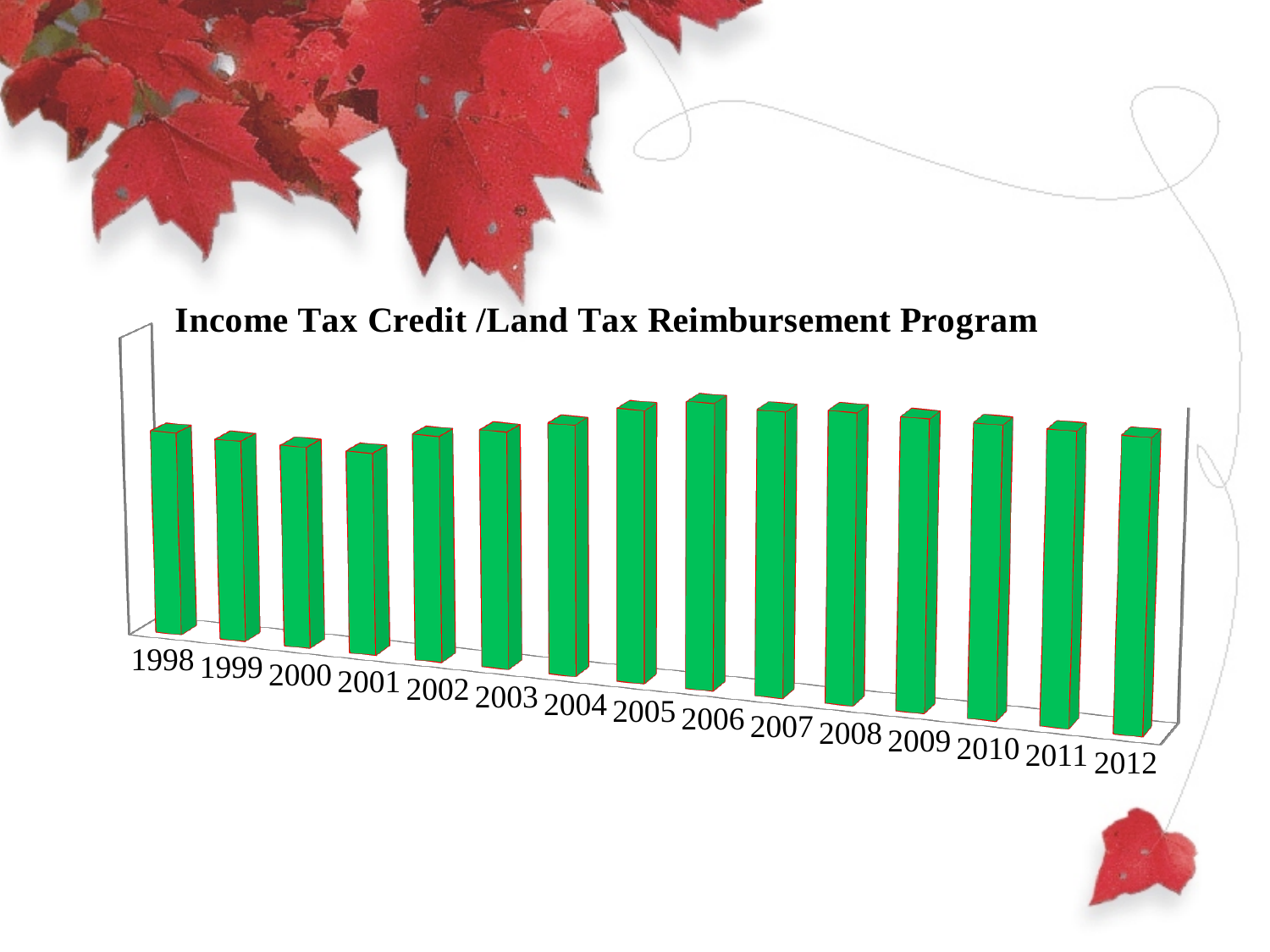
What is the title of the chart? Income Tax Credit /Land Tax Reimbursement Program What is the last year shown on the x axis? 2012 Do the bar values rise or fall from 2001 to 2006? rise How many years are plotted on the x axis of the chart? 15 What is the first year shown on the x axis? 1998 What kind of chart is shown on the slide? bar chart